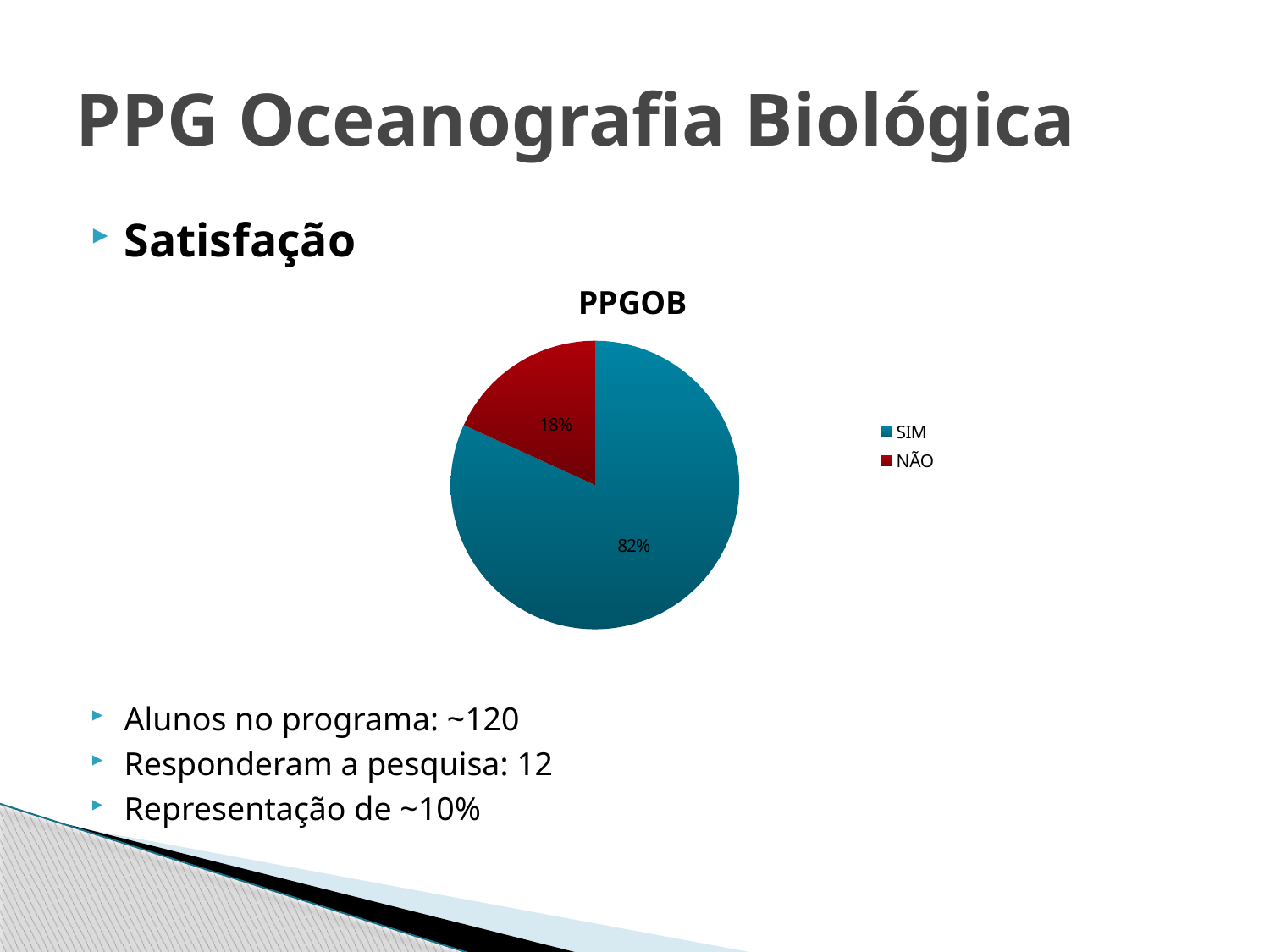
Which is larger, the SIM slice or the NÃO slice? SIM What colour is the NÃO slice? red What share of the pie does NÃO represent? 18% How many slices does the pie chart have? 2 What kind of chart is shown on the slide? pie chart What is the difference in percentage points between the SIM and NÃO slices? 64 Which slice is the smallest? NÃO Which slice is the largest? SIM What is the chart's title? PPGOB What share of the pie does SIM represent? 82% How many entries does the legend list? 2